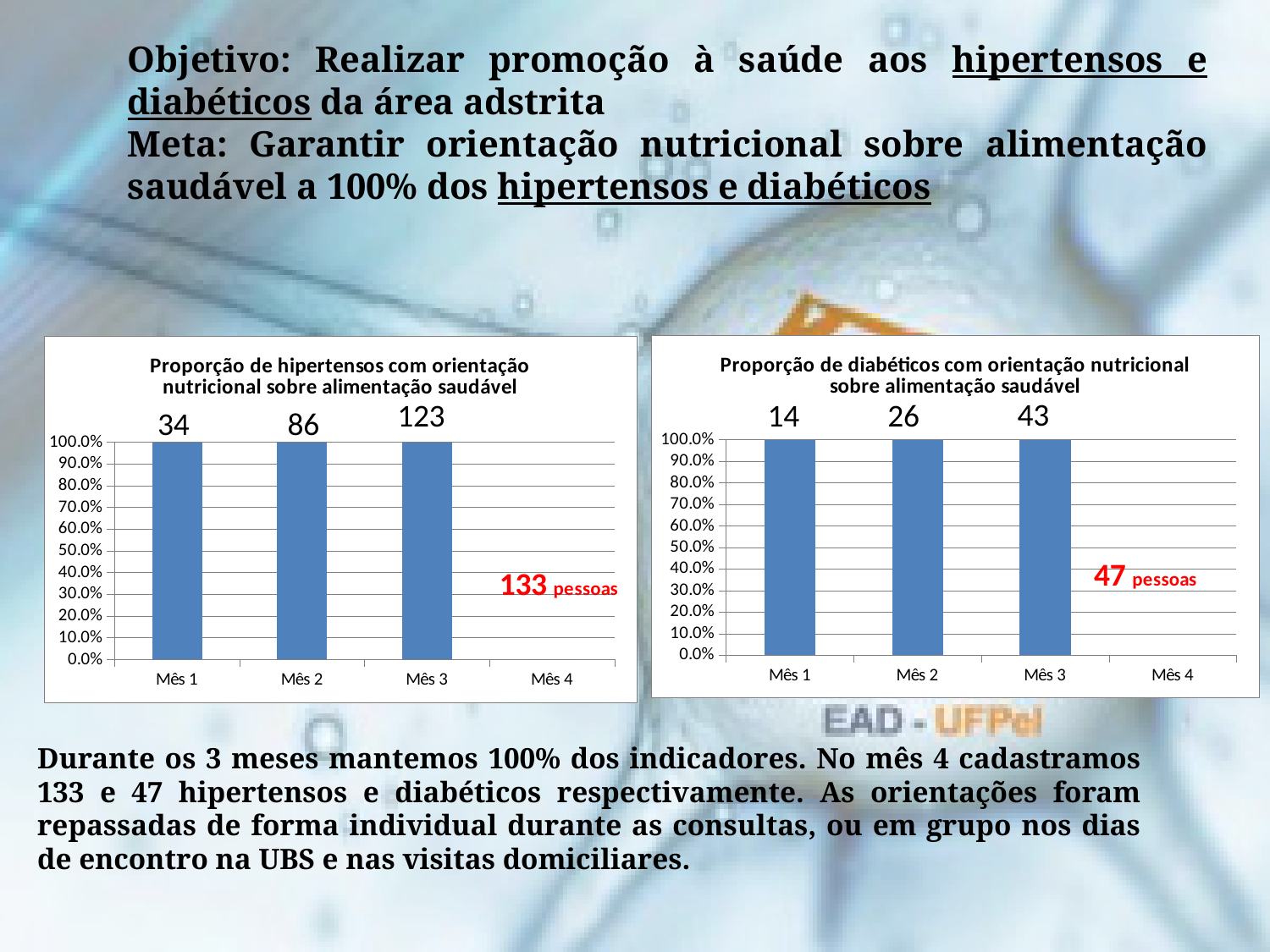
In the left chart (Proporção de hipertensos), what is the difference between the numbers printed for Mês 3 and Mês 1? 89 In the right chart (Proporção de diabéticos), do the numbers printed above the bars rise or fall from Mês 1 to Mês 3? Rise What red annotation is shown in the left chart (Proporção de hipertensos) near Mês 4? 133 pessoas How many month categories are shown on the x axis of the right chart (Proporção de diabéticos)? 4 In the right chart (Proporção de diabéticos), what number is printed above the bar for Mês 1? 14 In the right chart (Proporção de diabéticos), what number is printed above the bar for Mês 3? 43 In the left chart (Proporção de hipertensos), what percentage value does the bar for Mês 1 reach on the y axis? 100.0% What kind of chart is the left chart (Proporção de hipertensos)? Bar chart In the right chart (Proporção de diabéticos), what is the difference between the numbers printed for Mês 3 and Mês 2? 17 In the left chart (Proporção de hipertensos), what number is printed above the bar for Mês 2? 86 In the left chart (Proporção de hipertensos), what number is printed above the bar for Mês 3? 123 In the right chart (Proporção de diabéticos), what percentage value does the bar for Mês 2 reach on the y axis? 100.0%